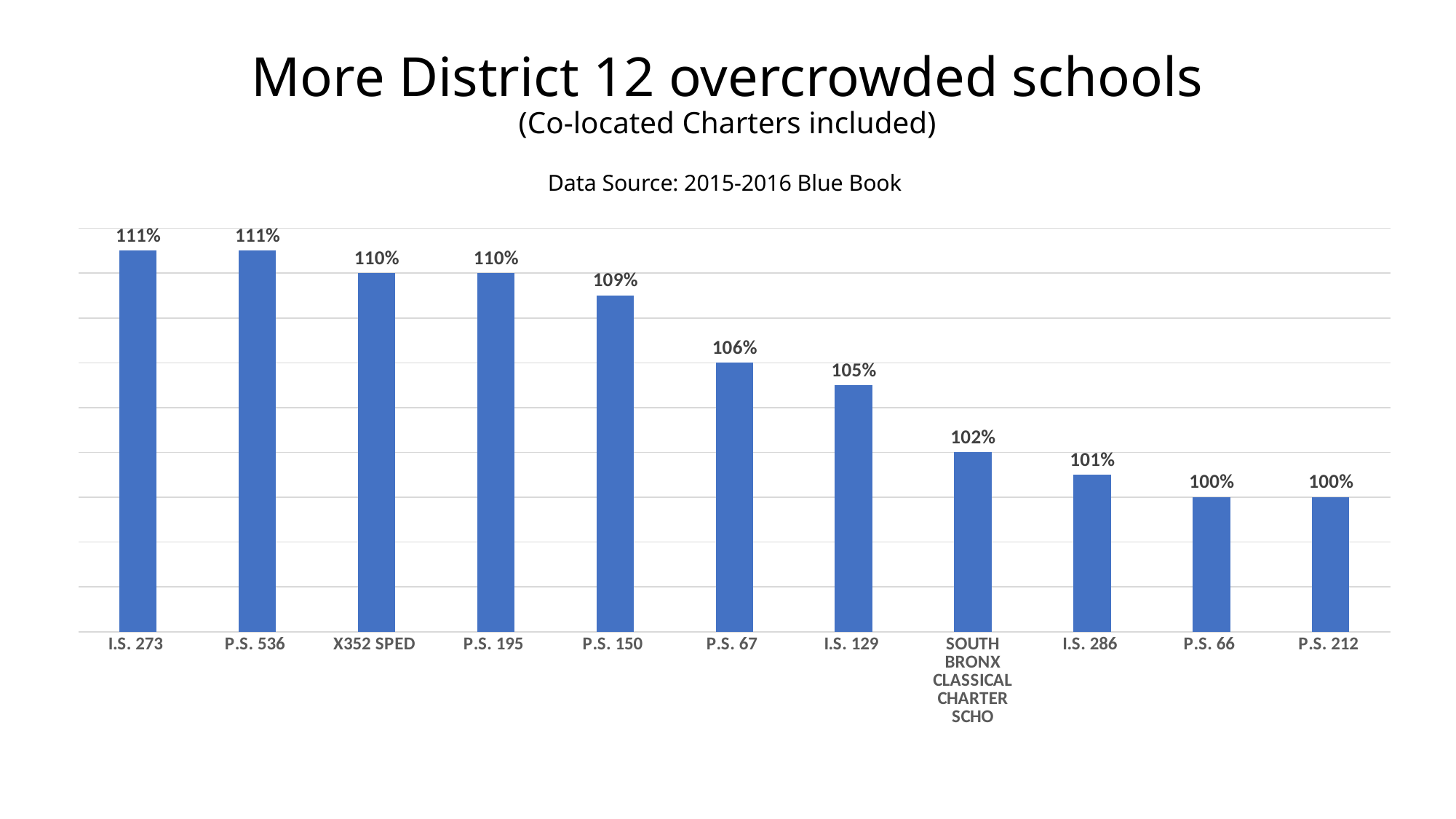
What is the lowest value shown on the chart? 100% What is the difference between the values for I.S. 273 and P.S. 212? 11% What is the value for X352 SPED? 110% What is the highest value shown on the chart? 111% What is the difference between the values for P.S. 67 and I.S. 286? 5% Which has a larger value, P.S. 195 or I.S. 129? P.S. 195 How many schools are shown on the chart? 11 What kind of chart is shown on the slide? Bar chart What is the value for I.S. 129? 105% What data source is cited on the slide? 2015-2016 Blue Book What is the value for South Bronx Classical Charter Scho? 102% What is the value for P.S. 150? 109%